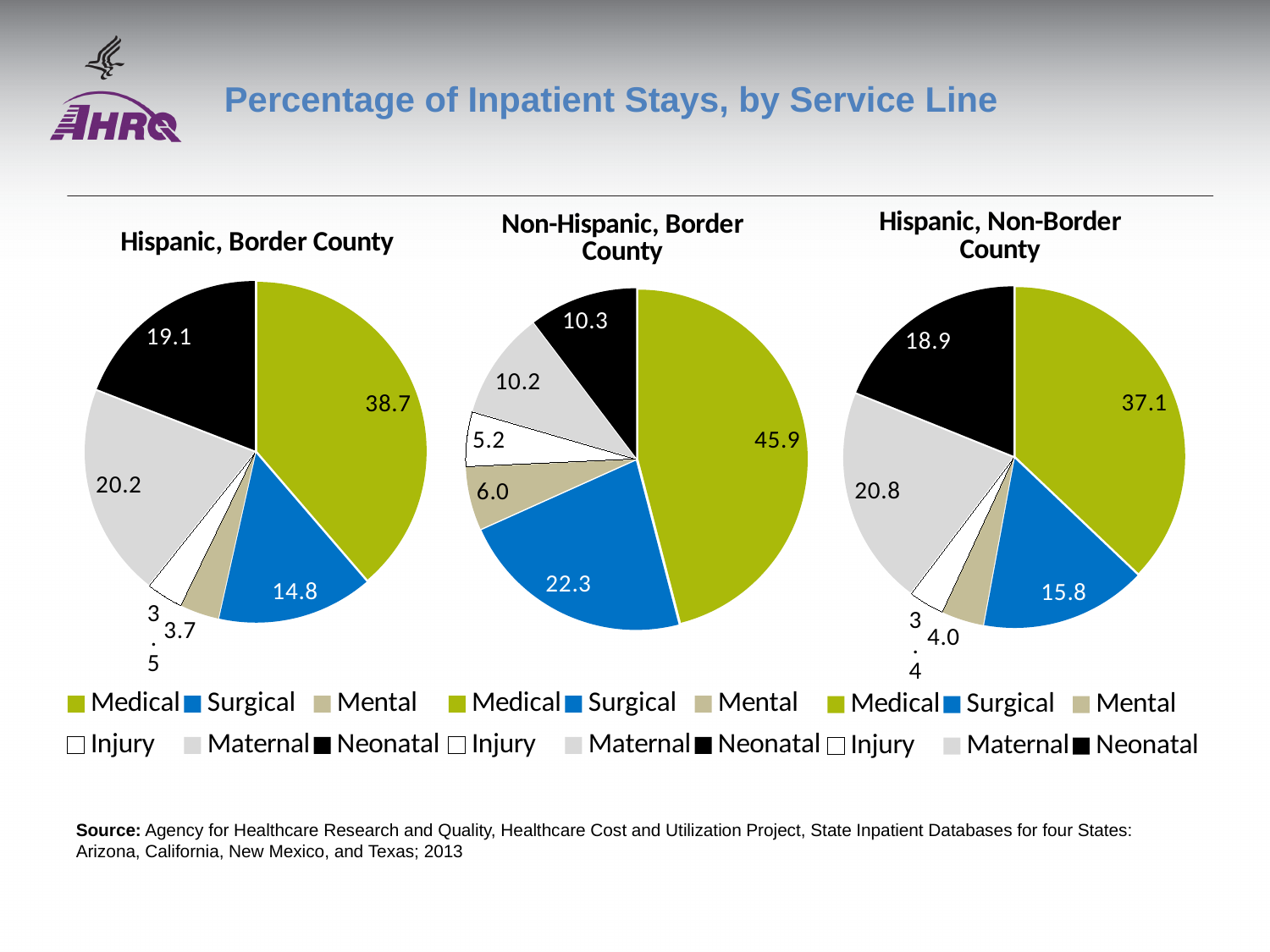
Which is larger in the Hispanic, Non-Border County chart: Surgical or Neonatal? Neonatal In the Non-Hispanic, Border County chart, what is the value for Surgical? 22.3 In the Hispanic, Non-Border County chart, what is the value for Maternal? 20.8 In the Non-Hispanic, Border County chart, what is the difference between the Medical and Surgical values? 23.6 In the Hispanic, Border County chart, what percentage of inpatient stays is Medical? 38.7 How many pie charts are shown on the slide? 3 What kind of chart is used on this slide? Pie chart How many service lines does the legend list for each pie chart? 6 In the Hispanic, Border County chart, what is the difference between the Maternal and Neonatal values? 1.1 What colour represents Neonatal in the legend? Black In the Hispanic, Non-Border County chart, which service line has the smallest share? Injury In the Non-Hispanic, Border County chart, which service line has the largest share? Medical